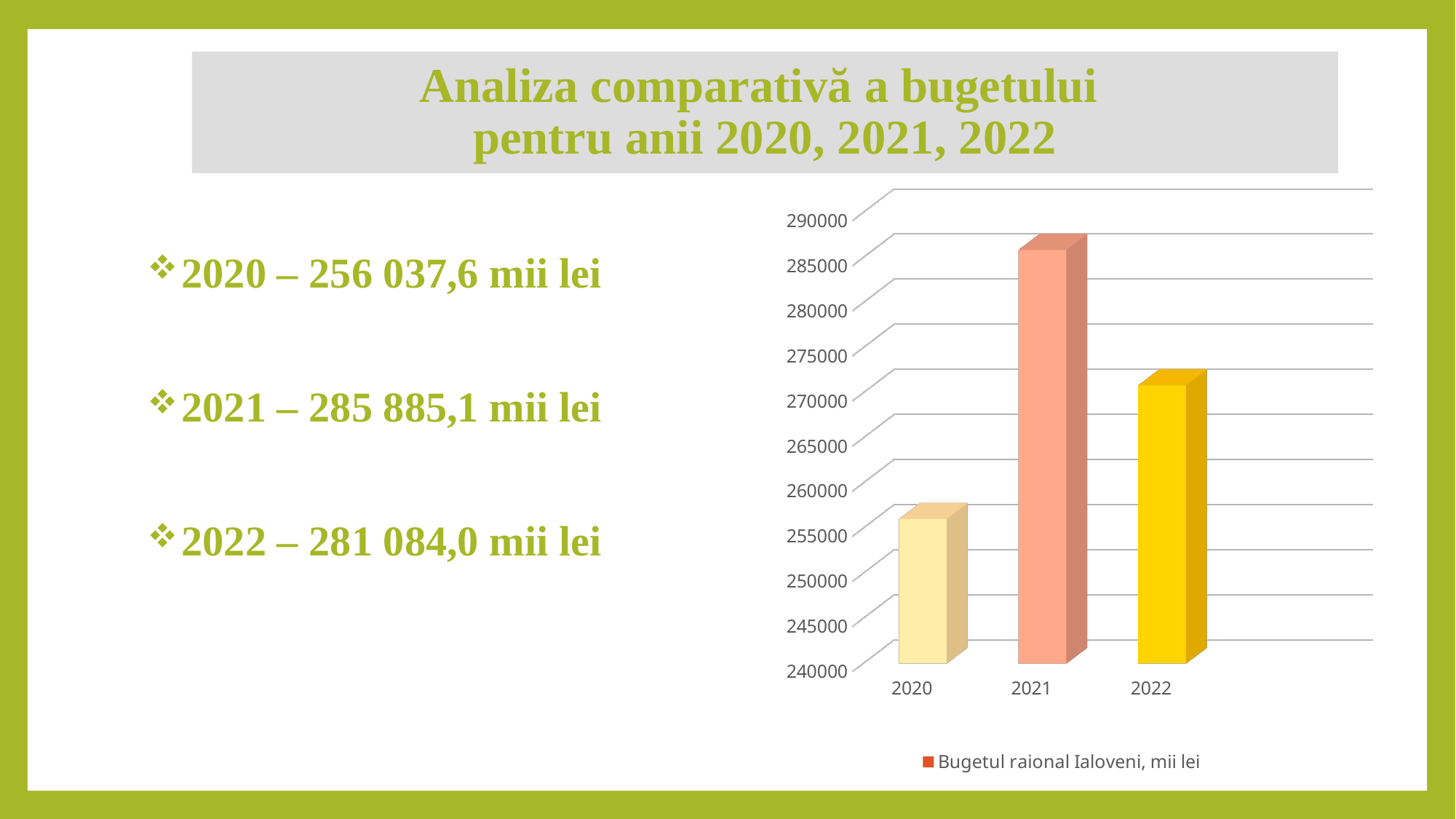
What is the budget value for 2021 as stated on the slide? 285 885,1 mii lei How many years (categories) are plotted on the chart? 3 How many series does the chart legend list? 1 Which is larger, the budget for 2021 or for 2022? 2021 What is the name of the series shown in the chart legend? Bugetul raional Ialoveni, mii lei Is the value of the 2022 bar greater or less than 275000? less Which year has the highest budget value in the chart? 2021 What is the budget value for 2020 as stated on the slide? 256 037,6 mii lei Is the value of the 2020 bar greater or less than 260000? less What kind of chart is shown on the slide? Bar chart What is the difference between the 2021 and 2020 budget values stated on the slide? 29 847,5 mii lei Which year has the lowest budget value in the chart? 2020